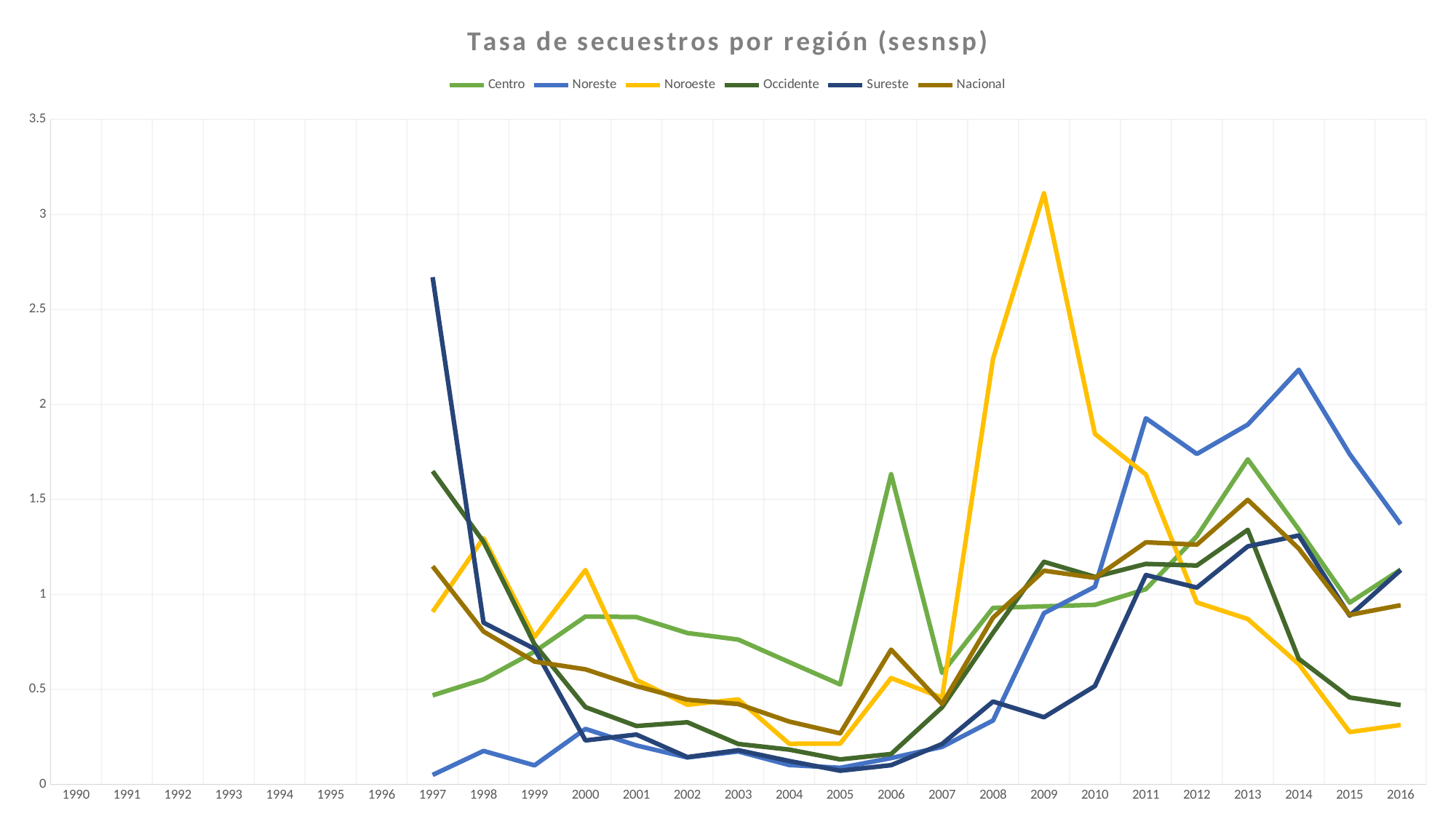
Is the value for Noreste in 1997 greater or less than 0.5? less Which series is drawn in yellow? Noroeste What is the title of the chart? Tasa de secuestros por región (sesnsp) Which series has the lowest value in 1997? Noreste Which series has the highest value in 2009? Noroeste How many years are labeled on the x axis? 27 Is the value for Noroeste in 2009 greater or less than 3? greater Does the Noroeste series rise or fall from 2009 to 2016? Falls Is the value for Sureste in 1997 greater or less than 2.5? greater What kind of chart is shown on the slide? Line chart How many series does the legend list? 6 Which is larger in 2013: the value for Centro or the value for Occidente? Centro